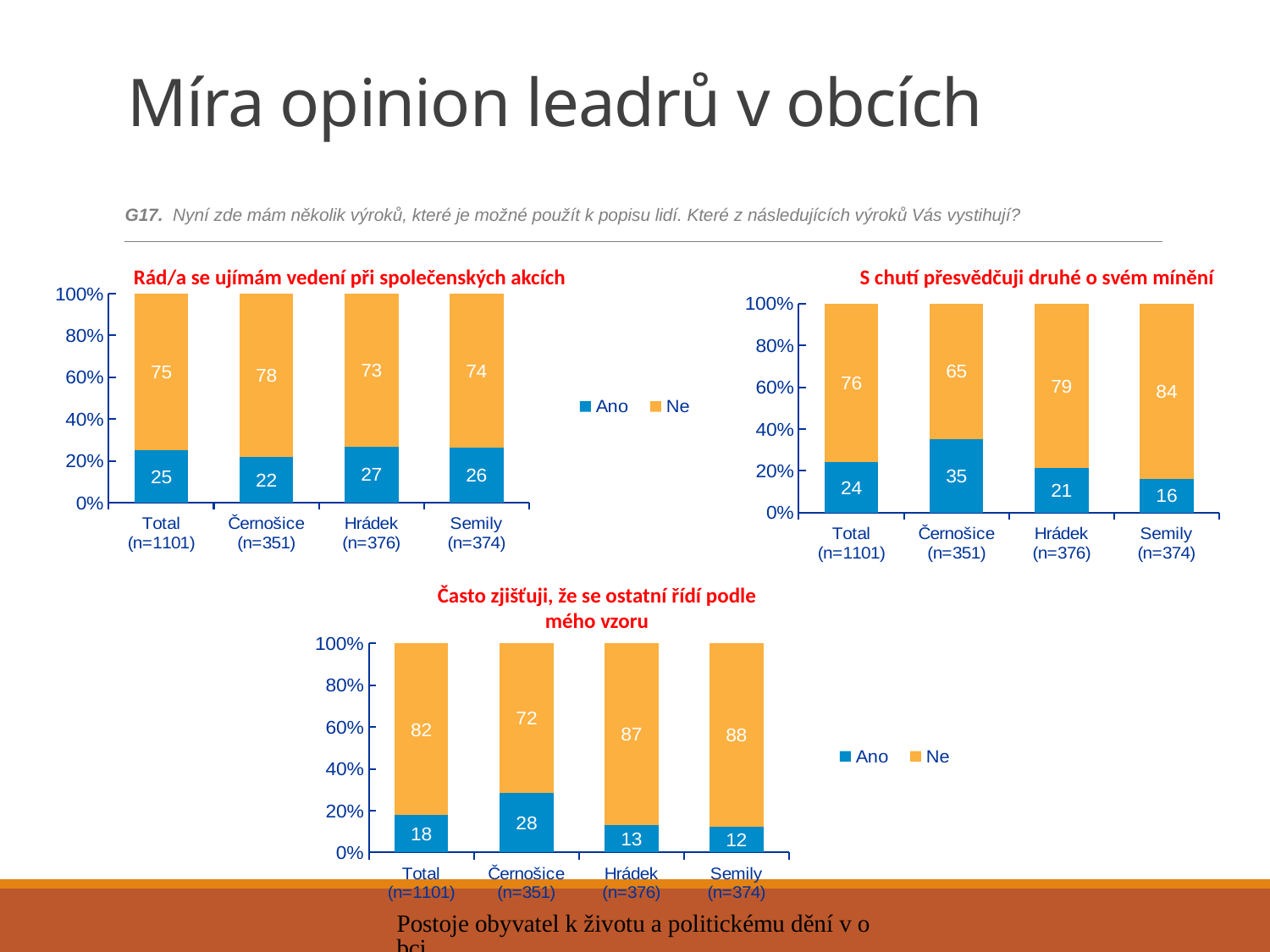
In the chart titled 'Často zjišťuji, že se ostatní řídí podle mého vzoru', which category has the lowest 'Ano' value? Semily (n=374) In the chart titled 'S chutí přesvědčuji druhé o svém mínění', is the 'Ano' value larger for Total (n=1101) or for Hrádek (n=376)? Total (n=1101) How many series does the legend of the chart titled 'Často zjišťuji, že se ostatní řídí podle mého vzoru' list? 2 What kind of chart is the chart titled 'S chutí přesvědčuji druhé o svém mínění'? Stacked bar chart In the chart titled 'Často zjišťuji, že se ostatní řídí podle mého vzoru', what is the 'Ano' value for Černošice (n=351)? 28 How many categories are shown on the x axis of the chart titled 'Rád/a se ujímám vedení při společenských akcích'? 4 In the chart titled 'Rád/a se ujímám vedení při společenských akcích', what is the 'Ano' value for Hrádek (n=376)? 27 In the chart titled 'Rád/a se ujímám vedení při společenských akcích', what is the difference between the 'Ne' values for Černošice (n=351) and Hrádek (n=376)? 5 In the chart titled 'S chutí přesvědčuji druhé o svém mínění', which category has the highest 'Ano' value? Černošice (n=351) In the chart titled 'Často zjišťuji, že se ostatní řídí podle mého vzoru', what is the difference between the 'Ne' values for Semily (n=374) and Černošice (n=351)? 16 In the chart titled 'Rád/a se ujímám vedení při společenských akcích', which colour represents the 'Ne' series? Orange In the chart titled 'S chutí přesvědčuji druhé o svém mínění', what is the 'Ne' value for Semily (n=374)? 84